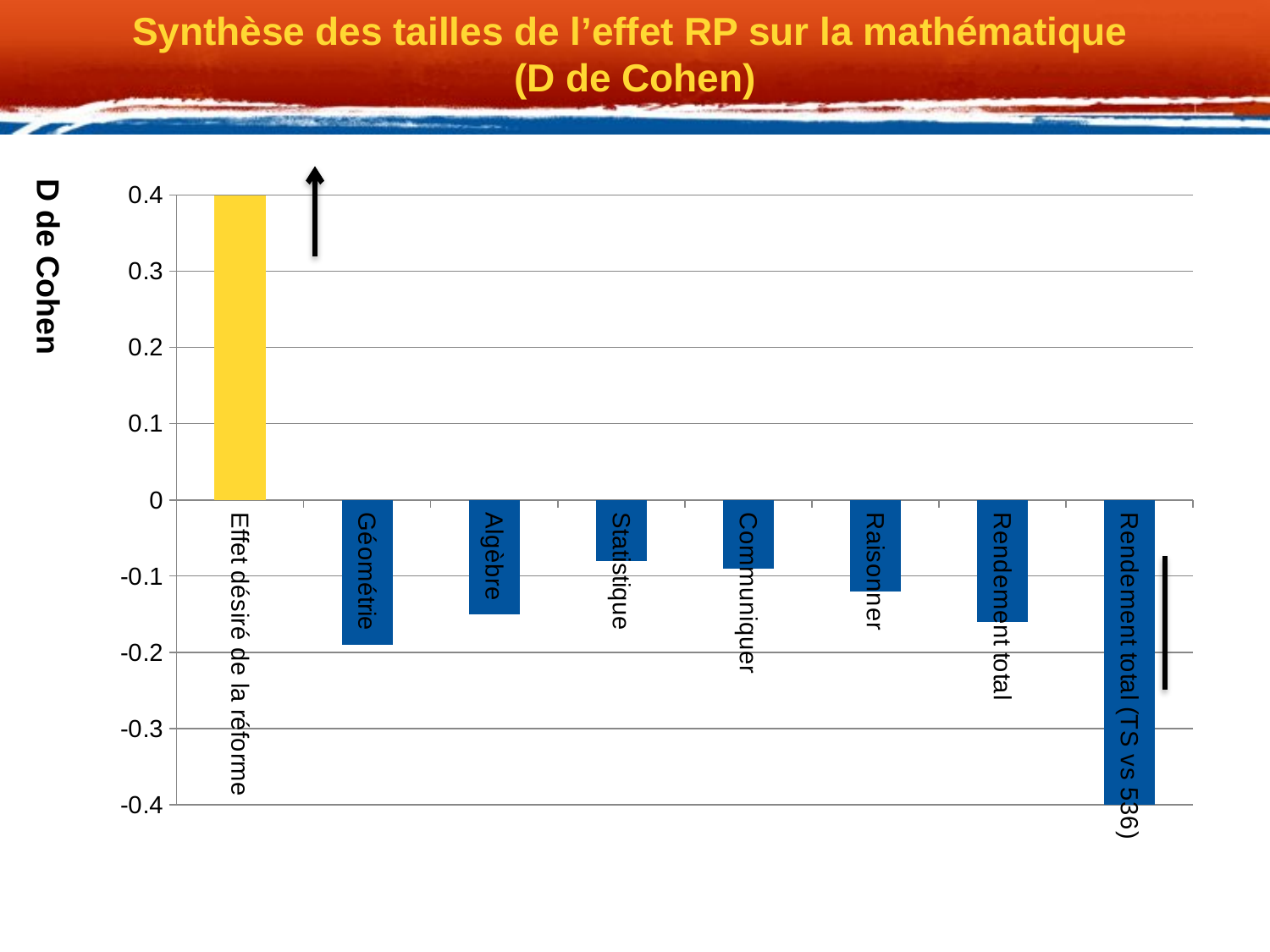
Which has the lower value, Raisonner or Statistique? Raisonner Is the value for Rendement total (TS vs 536) greater or less than -0.3? less What is the label of the vertical axis? D de Cohen Is the value for Statistique greater or less than -0.1? greater What is the value for Effet désiré de la réforme? 0.4 Is the value for Géométrie greater or less than -0.1? less Which category has the highest value in the chart? Effet désiré de la réforme Which category has the lowest value in the chart? Rendement total (TS vs 536) What colour is the bar for Effet désiré de la réforme? yellow Which has the lower value, Géométrie or Algèbre? Géométrie How many categories are plotted on the x axis of the chart? 8 What kind of chart is shown on the slide? bar chart